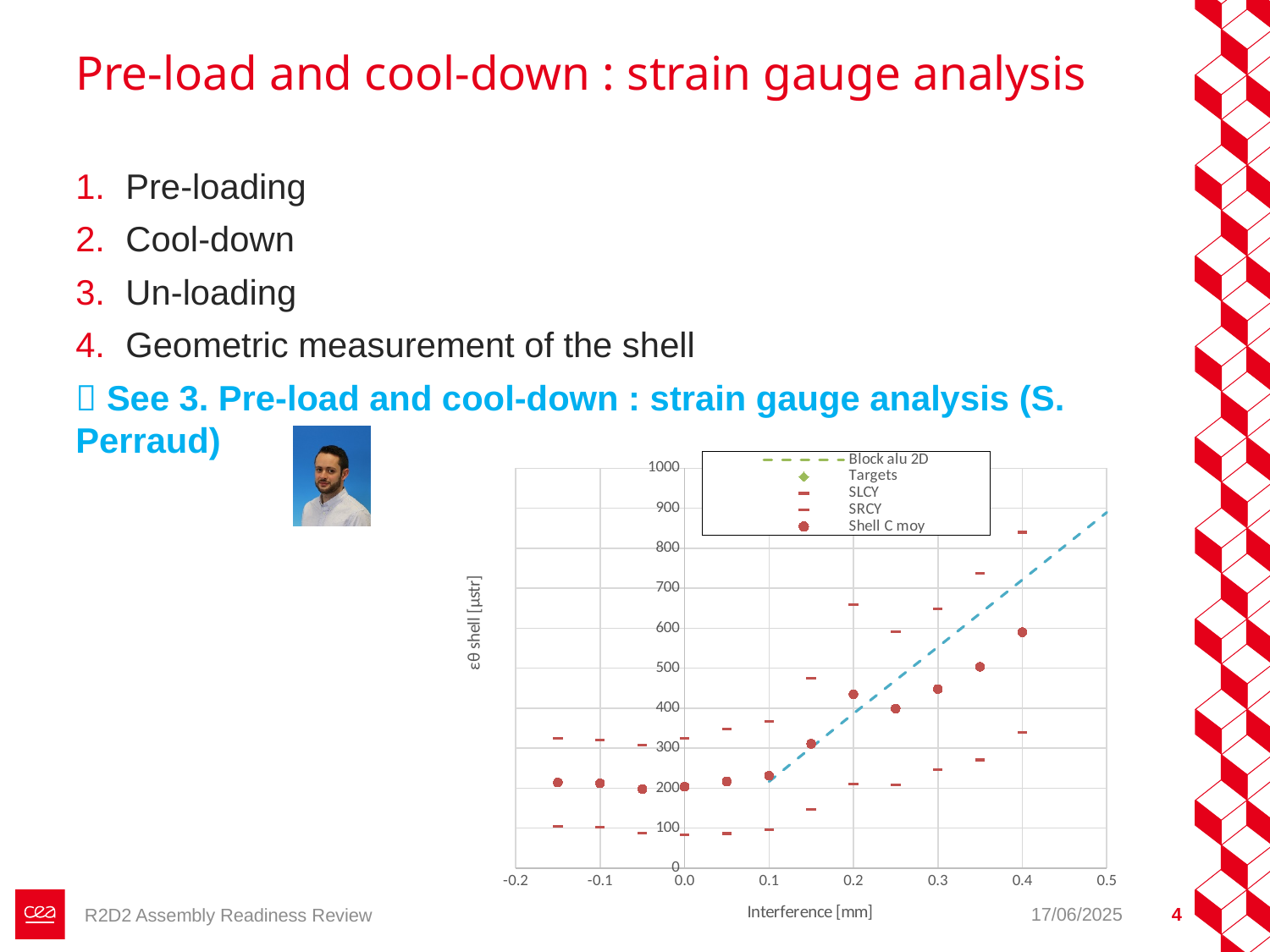
Is the Shell C moy value at an interference of -0.15 mm greater or less than 300? less Is the Shell C moy value at an interference of 0.4 mm greater or less than 500? greater What is the title of the x axis of the chart? Interference [mm] What kind of chart is shown on the slide? scatter chart Do the Shell C moy values rise or fall as interference increases from 0.1 mm to 0.4 mm? rise Is the Block alu 2D line at an interference of 0.5 mm greater or less than 800? greater How many series does the chart legend list? 5 Which Shell C moy value is larger: at an interference of 0.15 mm or at 0.3 mm? 0.3 mm At which interference value is the Shell C moy point highest? 0.4 What is the title of the y axis of the chart? εθ shell [µstr]